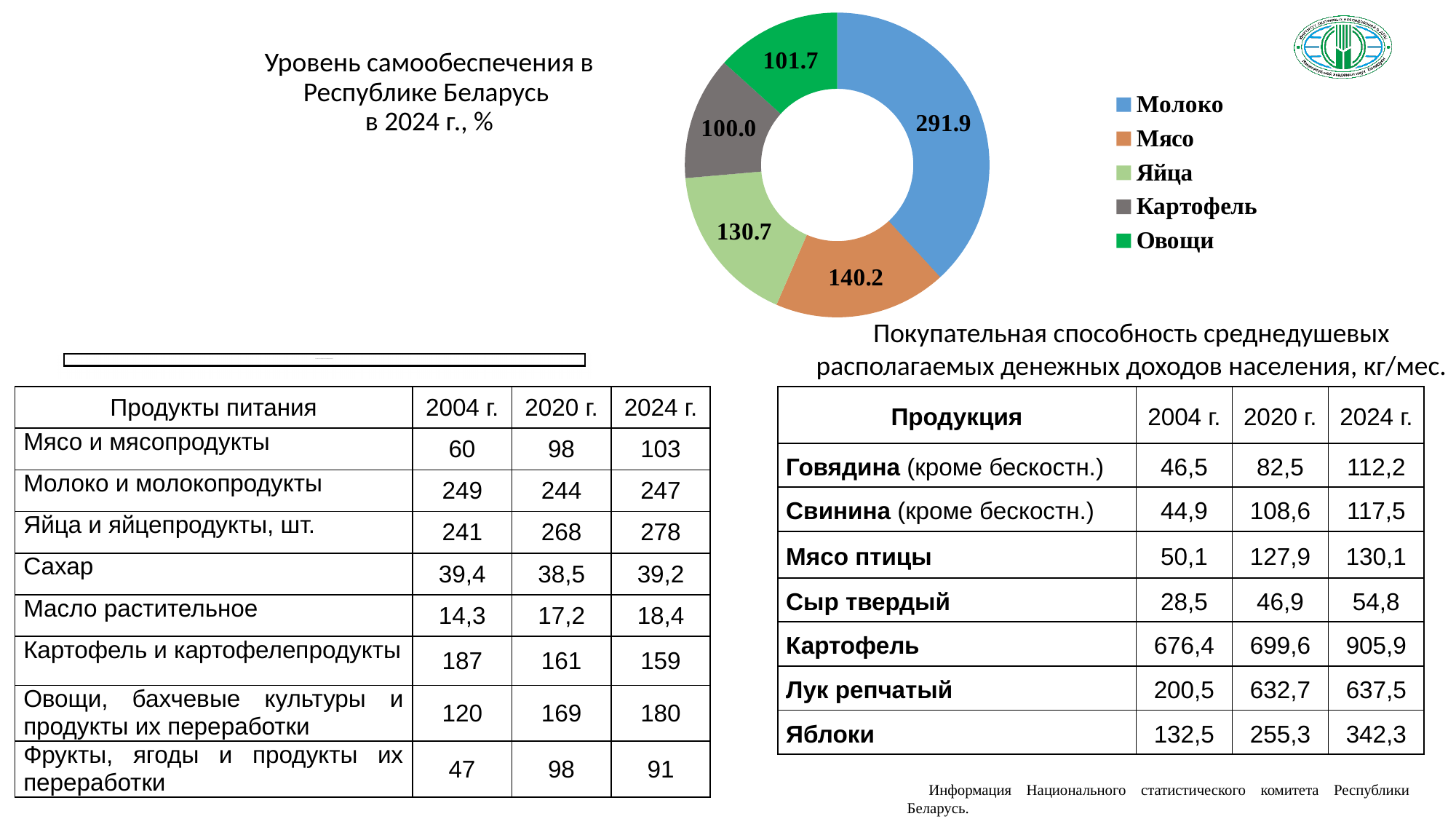
What is the value for Овощи in the chart? 101.7 What kind of chart is shown on the slide? doughnut chart What is the title of the chart? Уровень самообеспечения в Республике Беларусь в 2024 г., % What is the value for Молоко in the chart? 291.9 How many categories does the chart's legend list? 5 What is the difference between the values for Молоко and Мясо in the chart? 151.7 What is the value for Мясо in the chart? 140.2 Which is larger in the chart, the value for Молоко or the value for Мясо? Молоко What is the value for Яйца in the chart? 130.7 Which category has the lowest value in the chart? Картофель What is the value for Картофель in the chart? 100.0 Which category has the highest value in the chart? Молоко